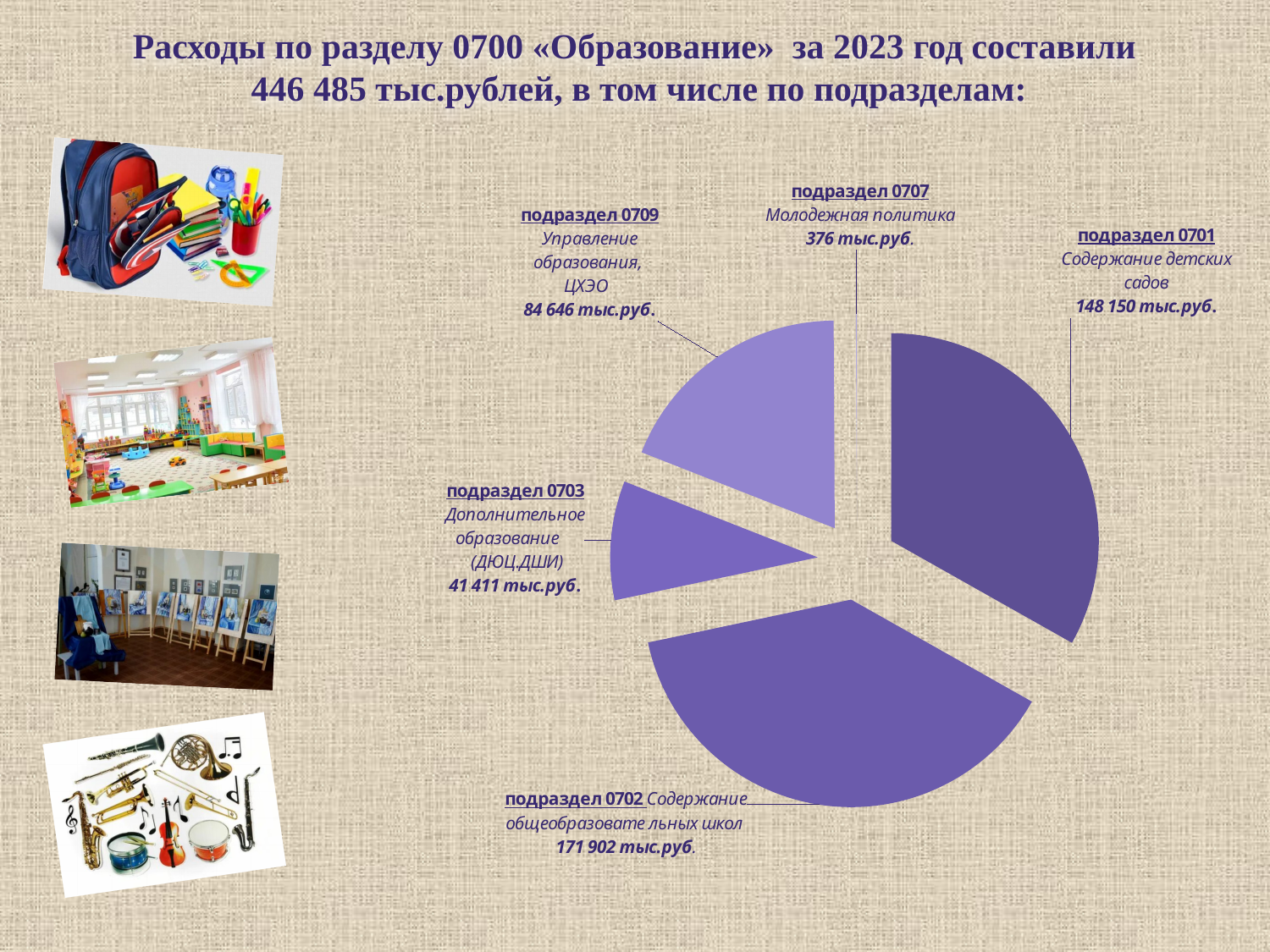
What kind of chart is shown on the slide? Pie chart What is the value for подраздел 0703 (Дополнительное образование)? 41 411 тыс.руб. What is the value for подраздел 0707 (Молодежная политика)? 376 тыс.руб. Which subsection has the largest expenditure? подраздел 0702 What is the value for подраздел 0709 (Управление образования, ЦХЭО)? 84 646 тыс.руб. How many slices (subsections) does the pie chart have? 5 Which subsection has the smallest expenditure? подраздел 0707 What is the value for подраздел 0702 (Содержание общеобразовательных школ)? 171 902 тыс.руб. What is the difference between the values for подраздел 0702 and подраздел 0701? 23 752 тыс.руб. What is the total expenditure across all subsections shown in the pie chart? 446 485 тыс.рублей Which is larger: the value for подраздел 0701 or подраздел 0709? подраздел 0701 What is the value for подраздел 0701 (Содержание детских садов)? 148 150 тыс.руб.